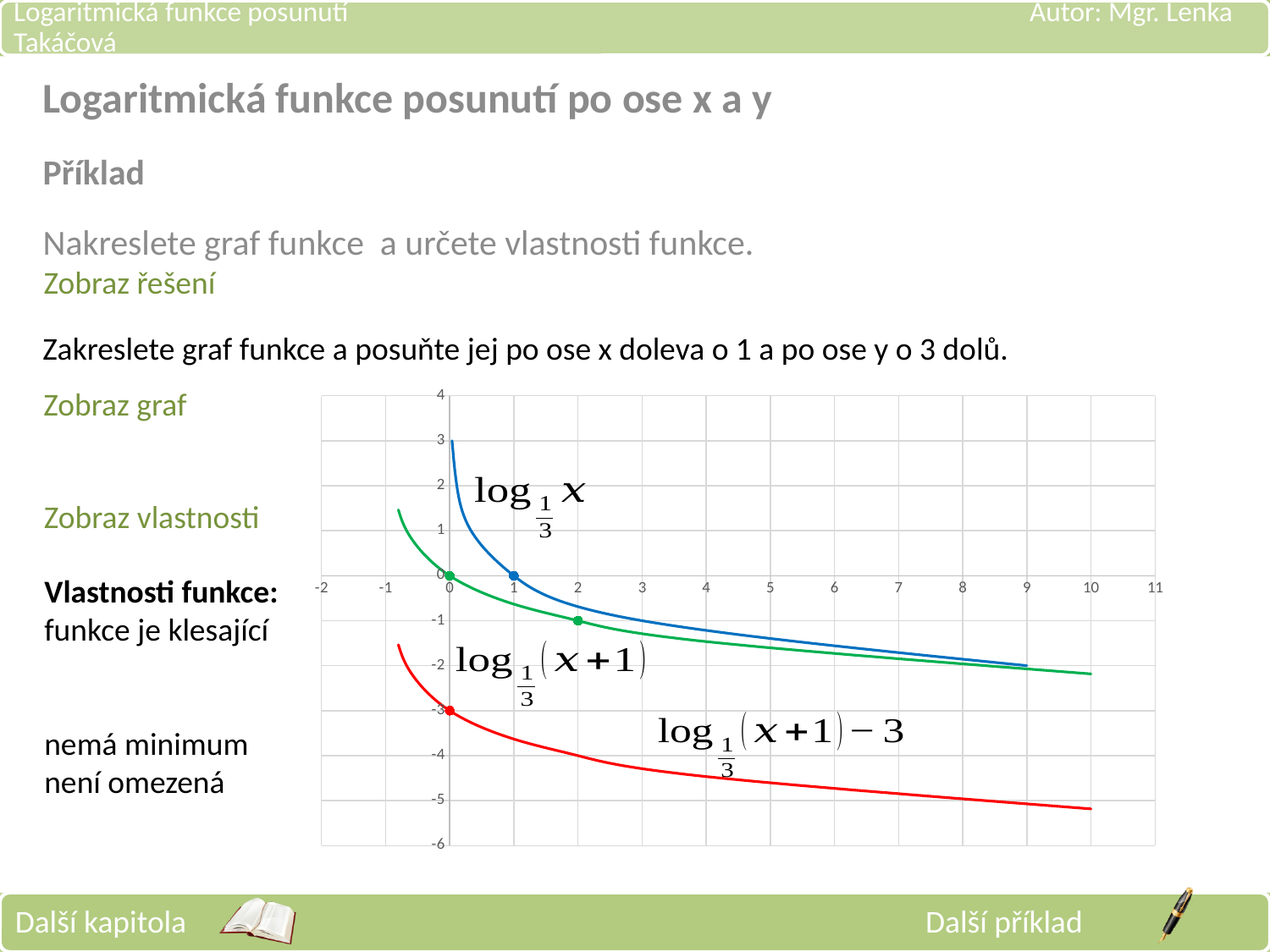
Do the values of the curves rise or fall as x increases? fall At x = 5, which curve has the larger value, the blue one or the red one? blue What kind of chart is shown on the slide? line chart Which curve lies lowest on the chart? log base 1/3 of (x+1) − 3 (red) What is the y value of the blue curve log base 1/3 of x at x = 1? 0 How many curves are plotted on the chart? 3 What is the y value of the green curve log base 1/3 of (x+1) at x = 0? 0 Is the value of the red curve at x = 10 greater or less than -4? less What colour is the curve labelled log base 1/3 of (x+1) − 3? red What is the y value of the green curve log base 1/3 of (x+1) at x = 2? -1 Is the value of the blue curve at x = 9 greater or less than -3? greater What is the y value of the red curve log base 1/3 of (x+1) − 3 at x = 0? -3